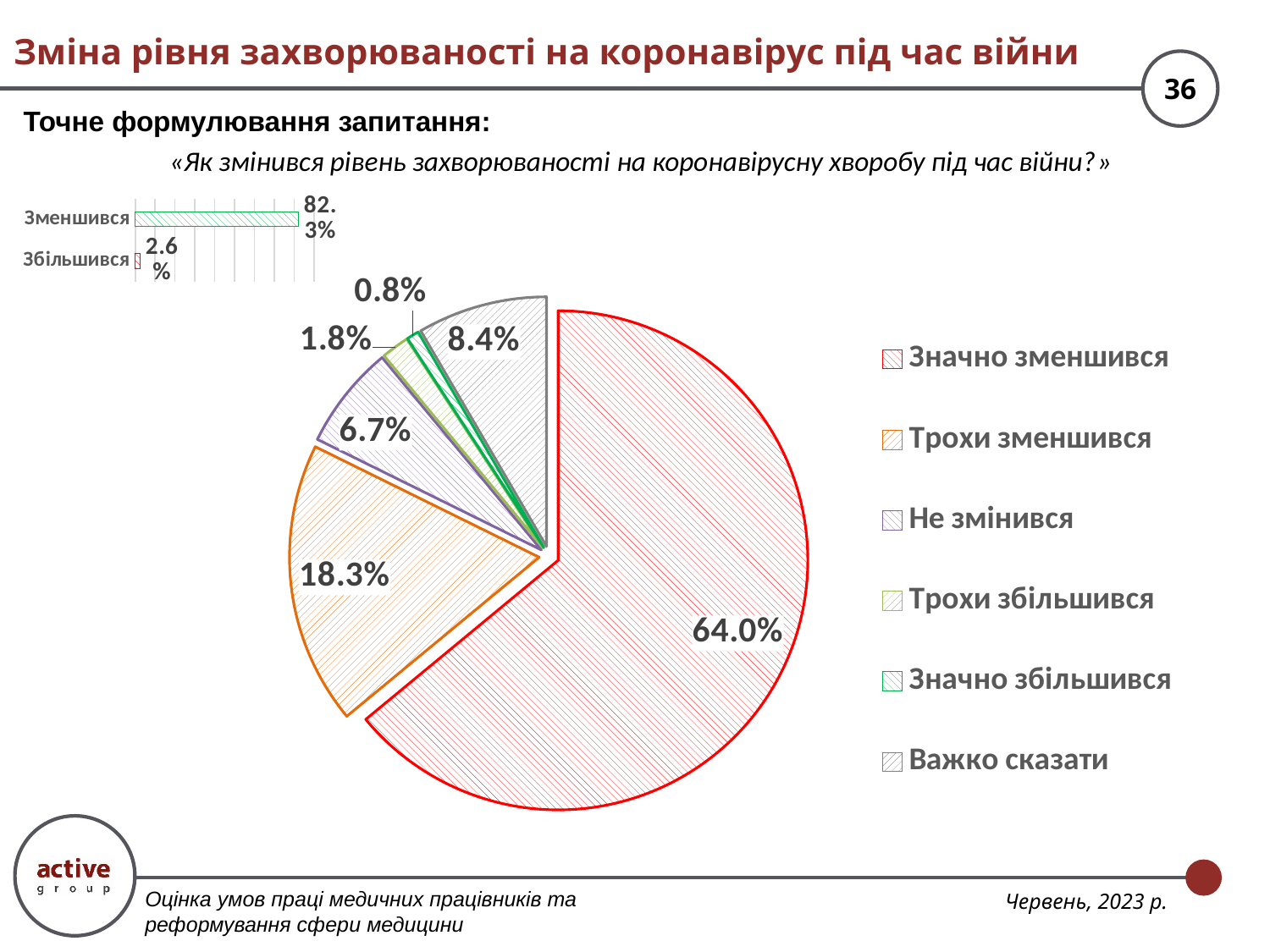
In the pie chart, what share of respondents answered "Важко сказати"? 8.4% In the pie chart, which answer has the largest share? Значно зменшився In the small bar chart at the top left, what is the value for "Зменшився"? 82.3% In the pie chart, what share of respondents answered "Значно збільшився"? 0.8% In the pie chart, what share of respondents answered "Трохи зменшився"? 18.3% In the small bar chart at the top left, what is the value for "Збільшився"? 2.6% How many categories does the pie chart's legend list? 6 What type of chart is the large chart in the centre of the slide? Pie chart In the pie chart, what share of respondents answered "Значно зменшився"? 64.0% In the pie chart, which answer has the smallest share? Значно збільшився In the pie chart, what is the difference in percentage points between "Значно зменшився" and "Трохи зменшився"? 45.7 In the pie chart, which is larger: "Не змінився" or "Важко сказати"? Важко сказати